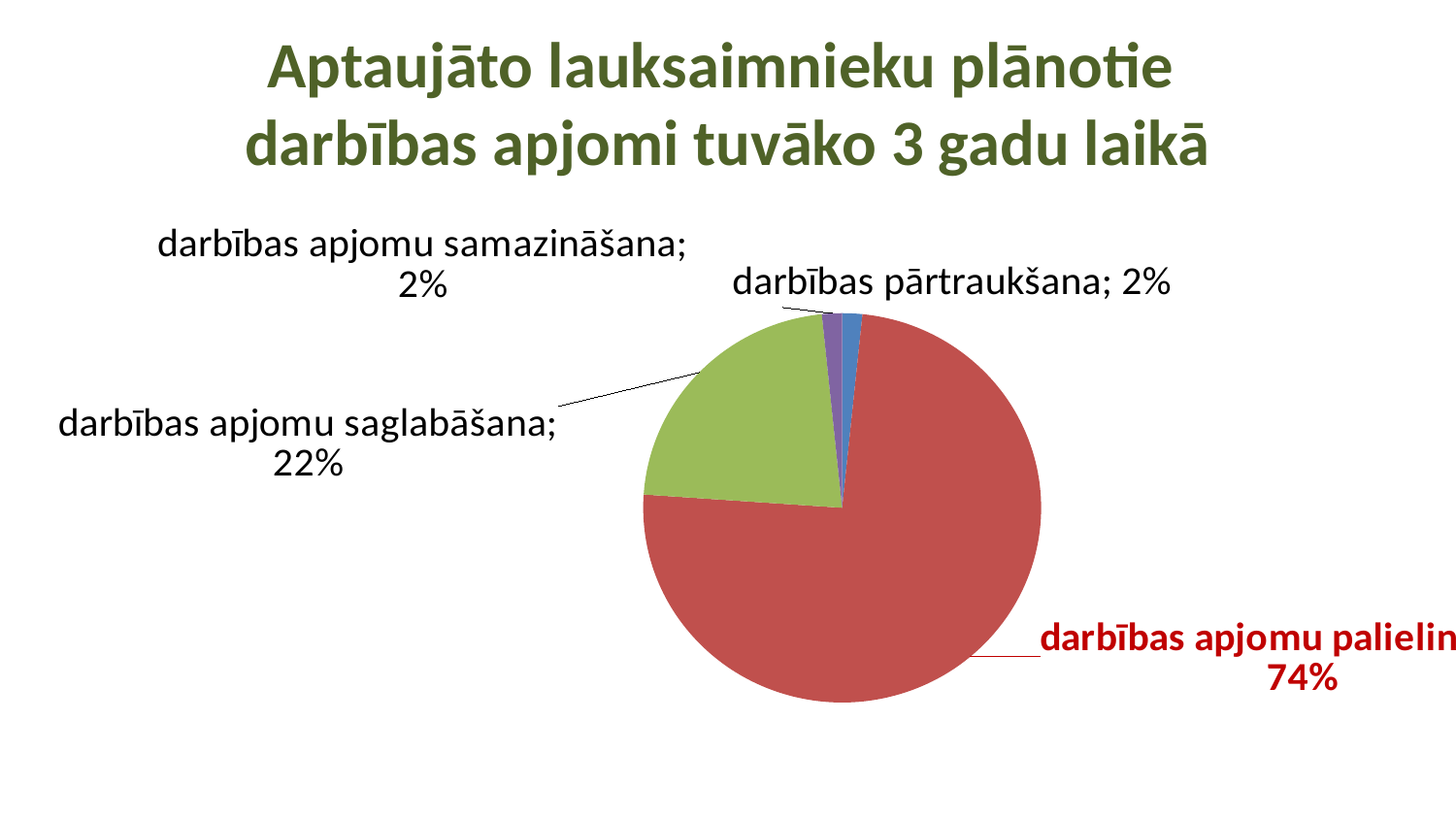
What is the value shown for 'darbības pārtraukšana'? 2% What is the value shown for 'darbības apjomu samazināšana'? 2% What is the combined share of 'darbības apjomu saglabāšana', 'darbības apjomu samazināšana' and 'darbības pārtraukšana'? 26% What is the difference between the largest slice (74%) and 'darbības apjomu saglabāšana'? 52 percentage points Which is larger: 'darbības apjomu saglabāšana' or 'darbības apjomu samazināšana'? darbības apjomu saglabāšana What percentage is shown for the largest (red) slice of the pie? 74% What is the title of the chart? Aptaujāto lauksaimnieku plānotie darbības apjomi tuvāko 3 gadu laikā Which slice is the largest in the pie chart? darbības apjomu palielināšana (the red slice, 74%) How many slices does the pie chart have? 4 What share of the pie is 'darbības apjomu saglabāšana'? 22% What kind of chart is shown on the slide? pie chart What colour is the slice for 'darbības apjomu saglabāšana'? green